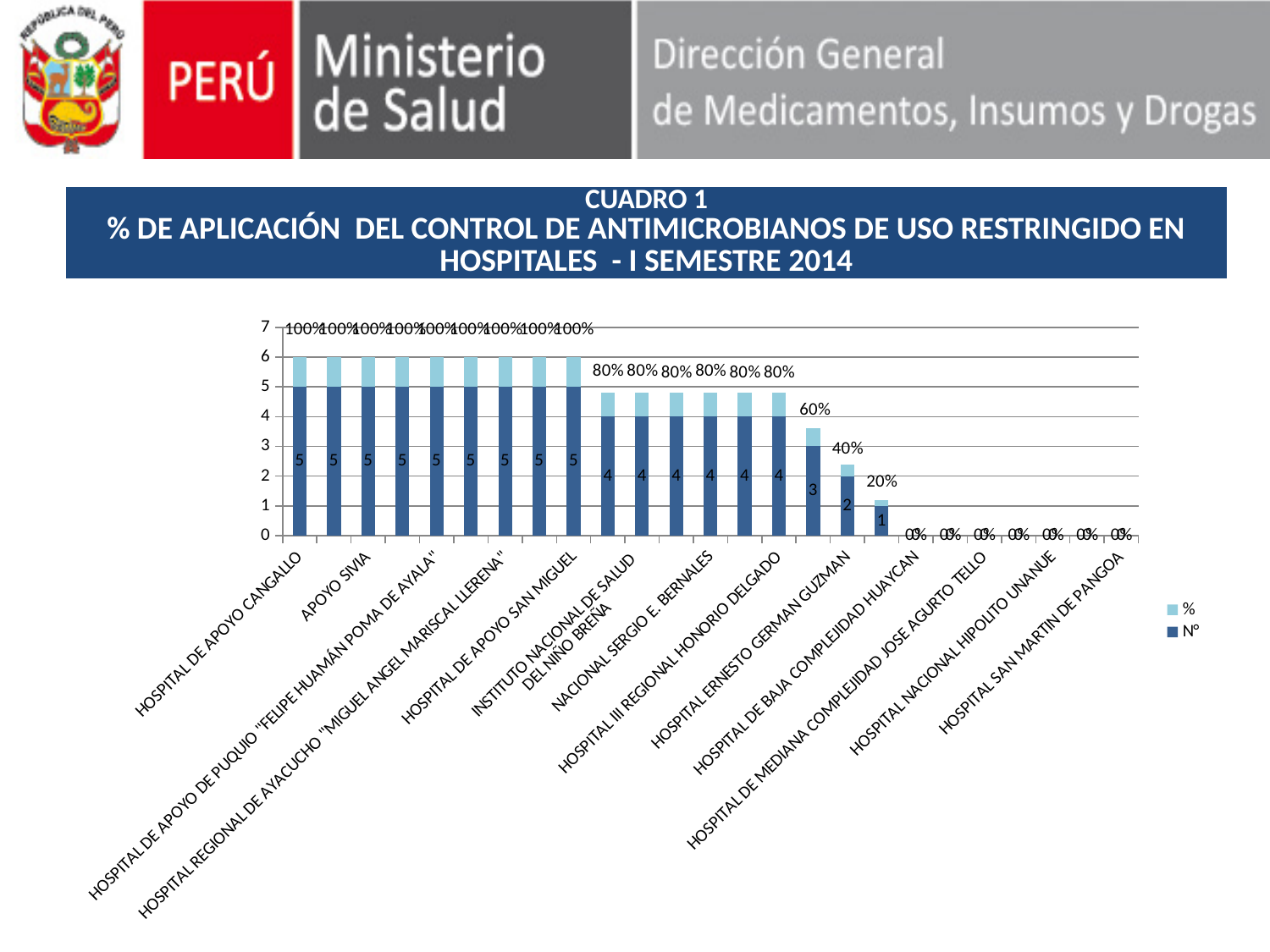
How many bars are labelled 100%? 9 What is the highest % value shown on the chart? 100% How many series does the chart legend list? 2 What is the % value for HOSPITAL DE APOYO CANGALLO? 100% What kind of chart is shown on the slide? Stacked bar chart What are the two series named in the chart legend? % and Nº What is the Nº value for HOSPITAL DE APOYO CANGALLO? 5 What is the maximum value shown on the vertical axis? 7 What is the lowest % value shown on the chart? 0% How many bars are labelled 80%? 6 Do the % values rise or fall moving from left to right along the x axis? Fall What is the % value for HOSPITAL SAN MARTIN DE PANGOA? 0%